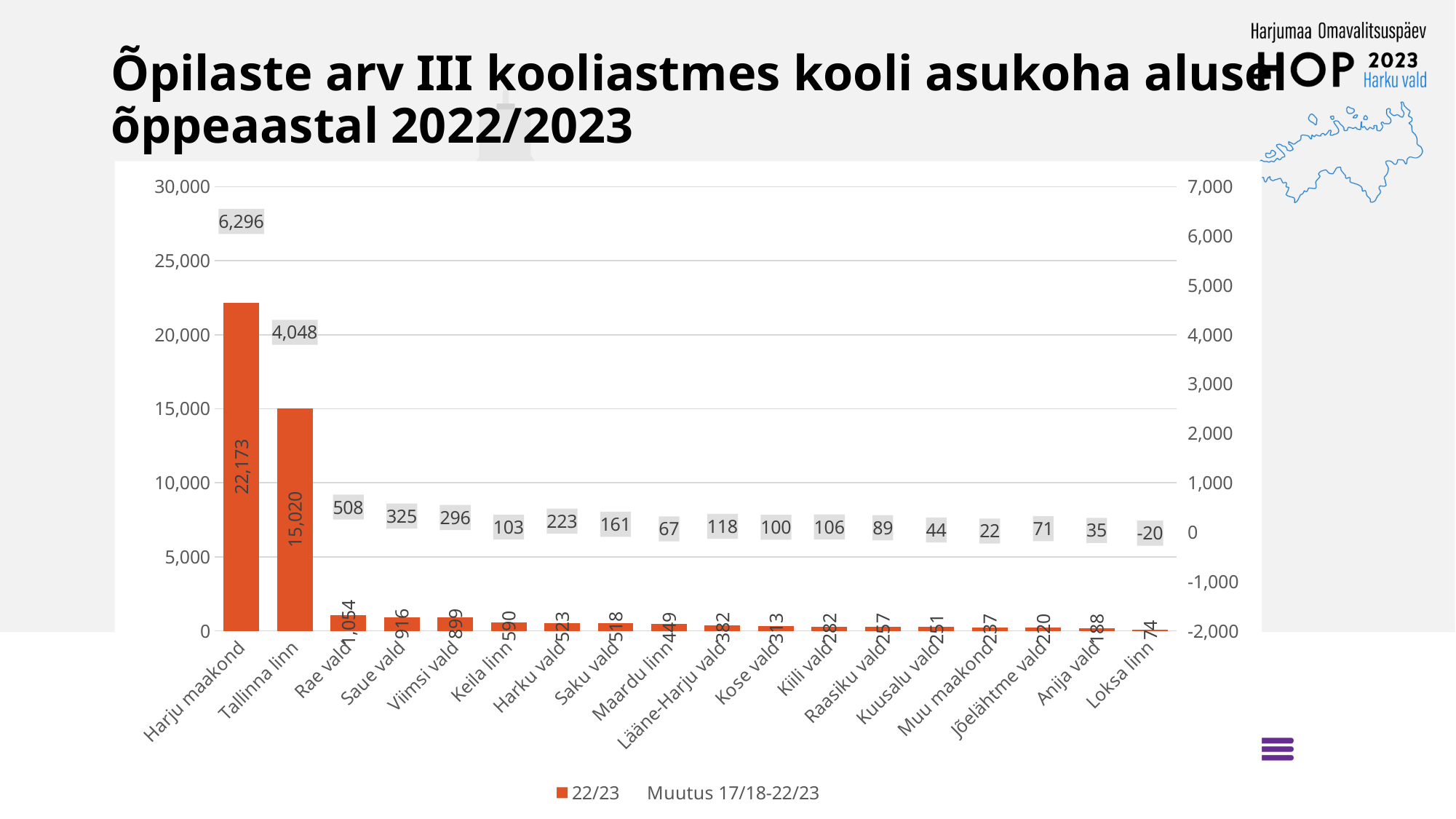
Which has the larger 22/23 value, Keila linn or Harku vald? Keila linn How many categories are shown on the x axis? 18 Which category has the highest 22/23 value? Harju maakond Is the 22/23 value for Tallinna linn greater or less than 10,000? greater Which category has the lowest 22/23 value? Loksa linn What is the Muutus 17/18-22/23 value for Loksa linn? -20 What is the 22/23 value for Tallinna linn? 15,020 What is the Muutus 17/18-22/23 value for Harju maakond? 6,296 What kind of chart is shown on the slide? bar chart What is the Muutus 17/18-22/23 value for Rae vald? 508 What is the difference between the 22/23 values for Harju maakond and Tallinna linn? 7,153 How many series does the legend list? 2